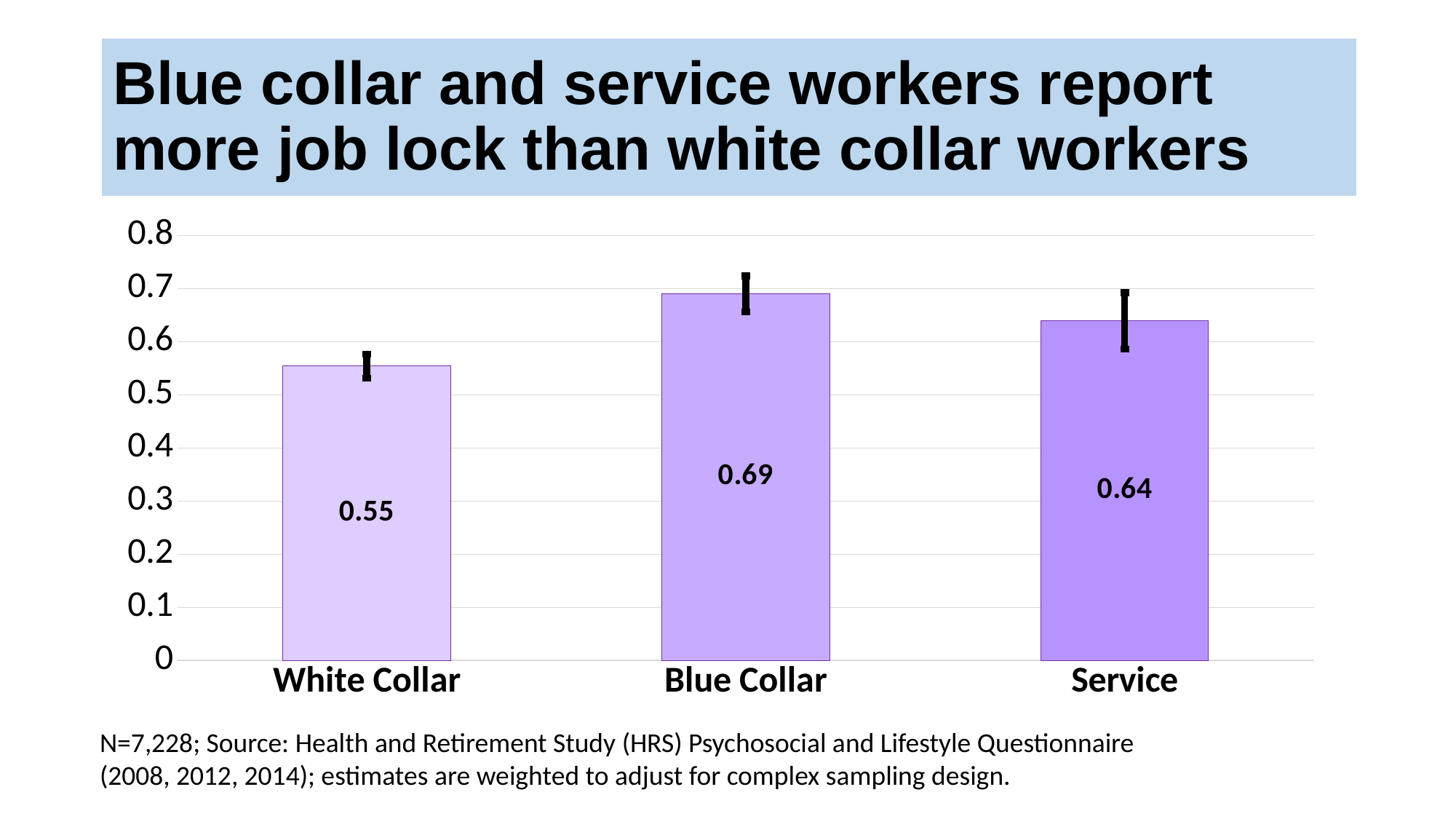
What is the value for White Collar? 0.55 What is the value for Blue Collar? 0.69 What is the title of the slide? Blue collar and service workers report more job lock than white collar workers What kind of chart is shown on the slide? bar chart Which category has the lowest value? White Collar Which category has the highest value? Blue Collar What is the difference between the values for Blue Collar and White Collar? 0.14 What is the difference between the values for Blue Collar and Service? 0.05 How many categories are shown on the x axis? 3 What is the value for Service? 0.64 Is the value for Blue Collar greater or less than 0.6? greater Which is larger, the value for Service or the value for White Collar? Service